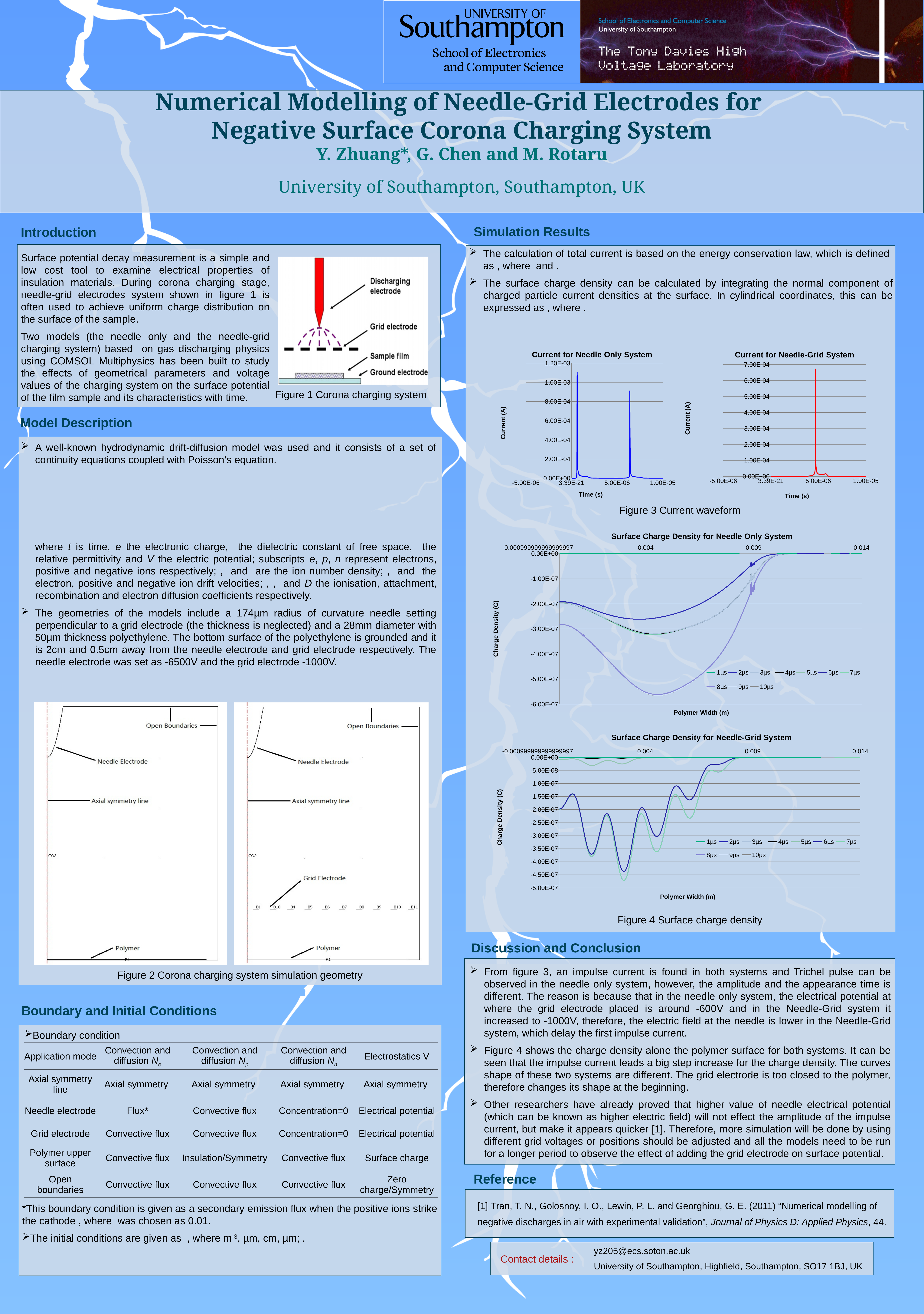
What is the x-axis title of the 'Current for Needle Only System' chart? Time (s) What colour is the line in the 'Current for Needle-Grid System' chart? red What kind of chart is the 'Current for Needle Only System' chart? line chart In the 'Current for Needle Only System' chart, is the first (highest) current peak greater or less than 1.00E-03? greater What kind of chart is the 'Surface Charge Density for Needle-Grid System' chart? line chart How many series does the legend list in the 'Surface Charge Density for Needle Only System' chart? 10 How many series does the legend list in the 'Surface Charge Density for Needle-Grid System' chart? 10 In the 'Current for Needle-Grid System' chart, is the peak current greater or less than 6.00E-04? greater Which chart shows a larger peak current, 'Current for Needle Only System' or 'Current for Needle-Grid System'? Current for Needle Only System